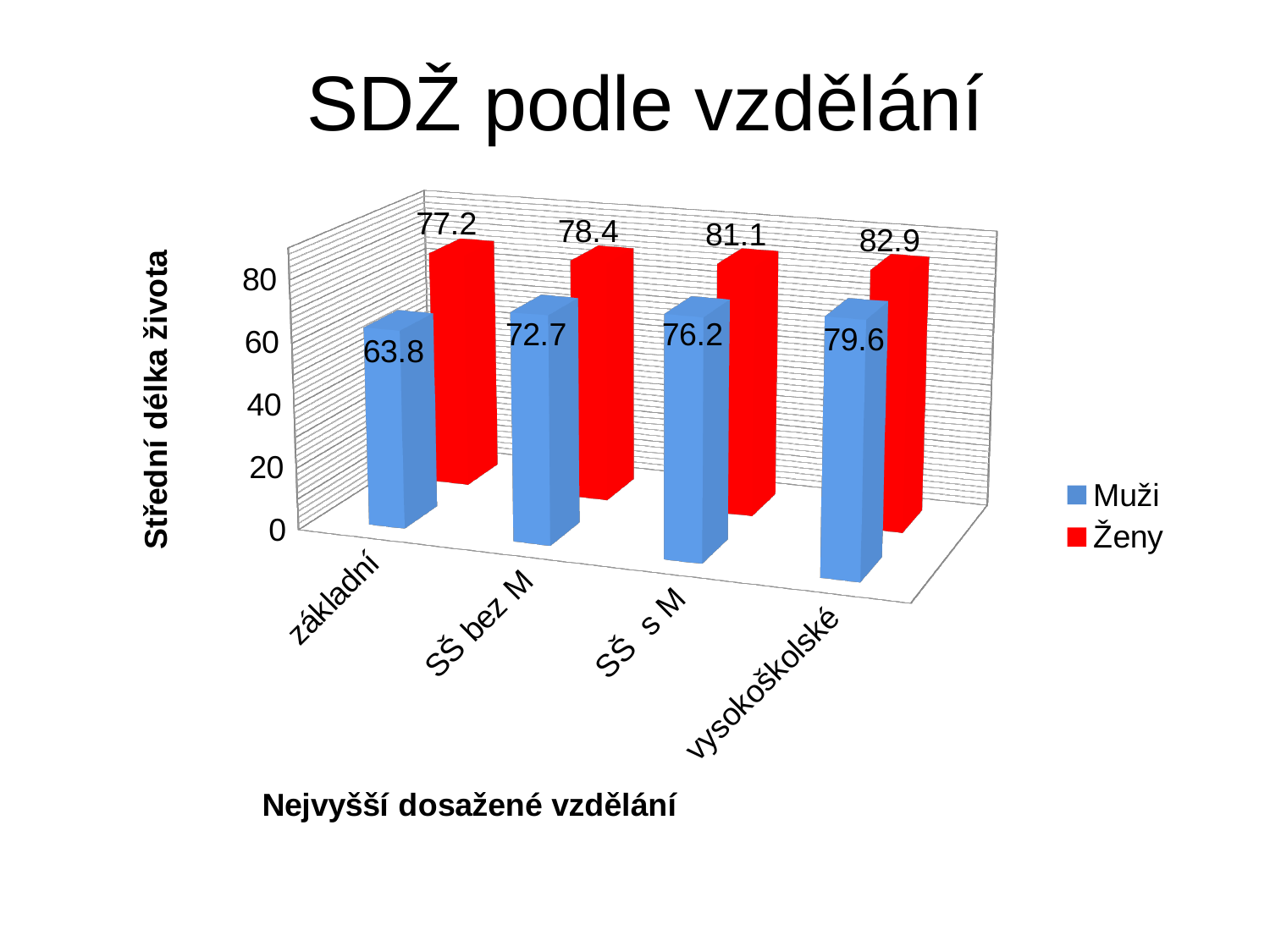
How many categories are shown on the x axis? 4 What kind of chart is shown on the slide? bar chart What is the difference between the Muži values for vysokoškolské and SŠ bez M? 6.9 Which category has the lowest value for Ženy? základní What is the value for Muži in the základní category? 63.8 How many series does the legend list? 2 What is the value for Ženy in the SŠ s M category? 81.1 Which is larger: Muži for SŠ s M or Ženy for SŠ bez M? Ženy for SŠ bez M Do the Muži values rise or fall from základní to vysokoškolské? rise What is the value for Ženy in the vysokoškolské category? 82.9 What is the difference between Ženy and Muži in the základní category? 13.4 Which category has the highest value for Muži? vysokoškolské